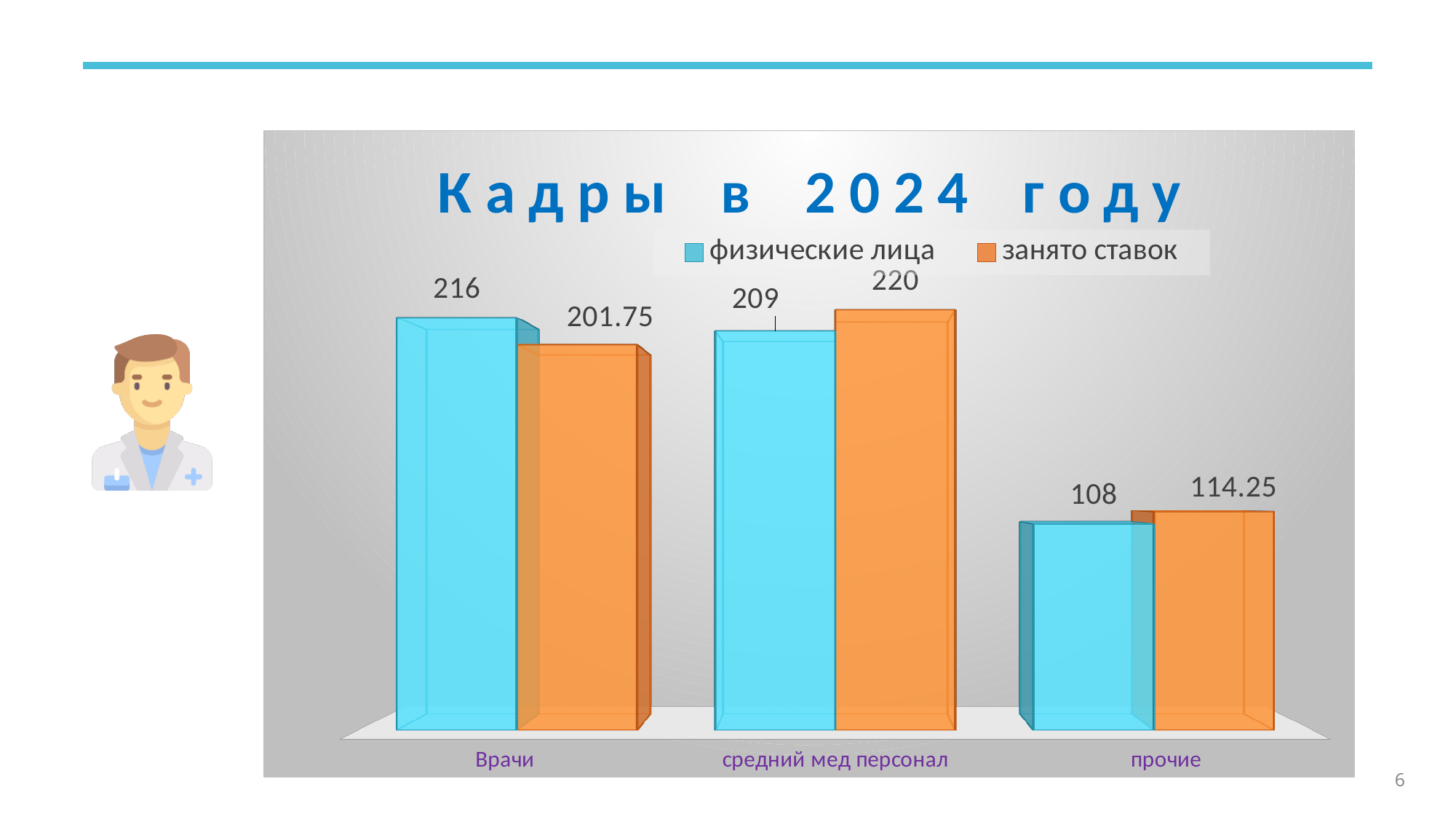
What is the difference between физические лица and занято ставок for Врачи? 14.25 For прочие, which is larger: физические лица or занято ставок? занято ставок What is the difference between занято ставок and физические лица for средний мед персонал? 11 Which category has the lowest value for физические лица? прочие What is the value of занято ставок for Врачи? 201.75 How many series does the legend list? 2 Which category has the highest value for занято ставок? средний мед персонал What is the value of занято ставок for средний мед персонал? 220 What is the value of физические лица for Врачи? 216 What is the title of the chart? Кадры в 2024 году How many categories are shown on the x axis? 3 What is the value of физические лица for прочие? 108